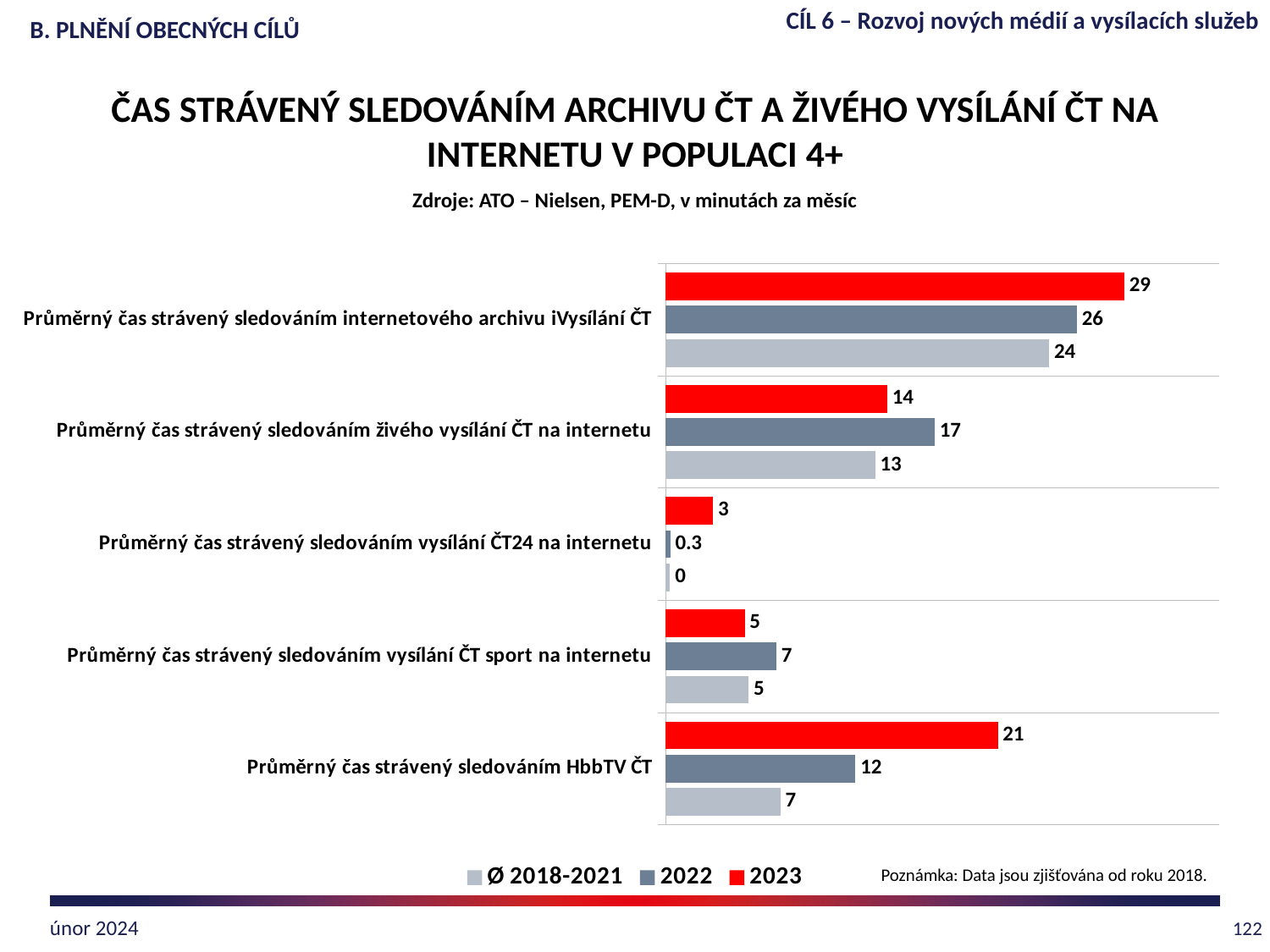
What is the 2022 value for 'Průměrný čas strávený sledováním živého vysílání ČT na internetu'? 17 What kind of chart is shown on the slide? Bar chart Which category has the lowest Ø 2018-2021 value? Průměrný čas strávený sledováním vysílání ČT24 na internetu How many categories are shown on the chart? 5 Which category has the highest 2023 value? Průměrný čas strávený sledováním internetového archivu iVysílání ČT How many series does the legend list? 3 What is the difference between the 2023 and 2022 values for 'Průměrný čas strávený sledováním HbbTV ČT'? 9 What is the 2022 value for 'Průměrný čas strávený sledováním vysílání ČT24 na internetu'? 0.3 What is the Ø 2018-2021 value for 'Průměrný čas strávený sledováním HbbTV ČT'? 7 Which colour represents the 2023 series in the legend? Red For 'Průměrný čas strávený sledováním živého vysílání ČT na internetu', which is larger: the 2022 value or the 2023 value? 2022 What is the 2023 value for 'Průměrný čas strávený sledováním internetového archivu iVysílání ČT'? 29